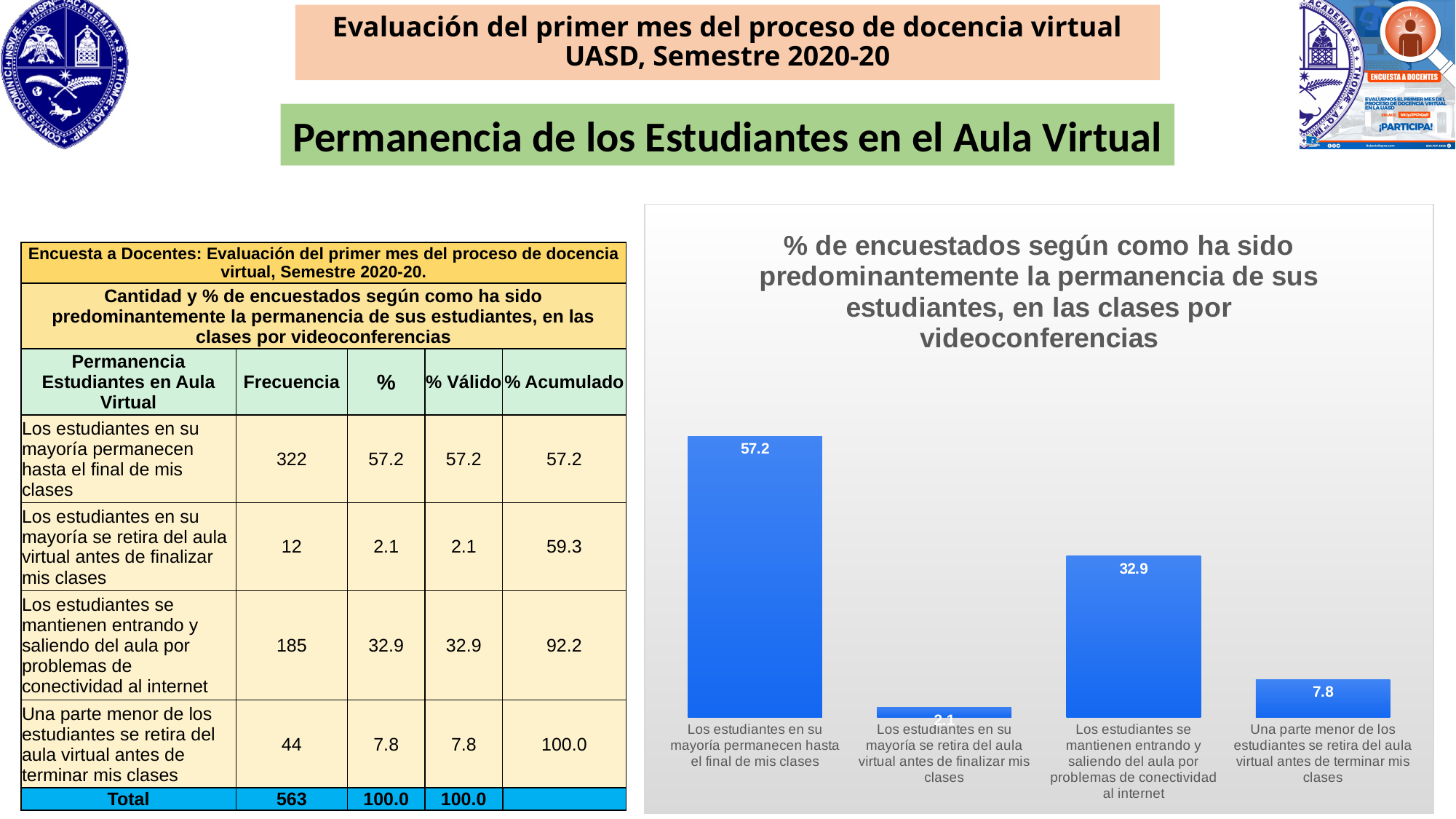
What is the difference between the values for "Los estudiantes se mantienen entrando y saliendo del aula por problemas de conectividad al internet" and "Una parte menor de los estudiantes se retira del aula virtual antes de terminar mis clases"? 25.1 What is the value for "Una parte menor de los estudiantes se retira del aula virtual antes de terminar mis clases" in the bar chart? 7.8 Which category has the lowest value in the bar chart? Los estudiantes en su mayoría se retira del aula virtual antes de finalizar mis clases What is the value for "Los estudiantes en su mayoría permanecen hasta el final de mis clases" in the bar chart? 57.2 What is the value for "Los estudiantes se mantienen entrando y saliendo del aula por problemas de conectividad al internet" in the bar chart? 32.9 What is the title of the bar chart? % de encuestados según como ha sido predominantemente la permanencia de sus estudiantes, en las clases por videoconferencias Which category has the highest value in the bar chart? Los estudiantes en su mayoría permanecen hasta el final de mis clases How many categories are plotted in the bar chart? 4 What colour are the bars in the chart? Blue What type of chart is shown on the slide? Bar chart Which is larger: the value for "Los estudiantes se mantienen entrando y saliendo del aula por problemas de conectividad al internet" or the value for "Una parte menor de los estudiantes se retira del aula virtual antes de terminar mis clases"? Los estudiantes se mantienen entrando y saliendo del aula por problemas de conectividad al internet What is the difference between the values for "Los estudiantes en su mayoría permanecen hasta el final de mis clases" and "Los estudiantes se mantienen entrando y saliendo del aula por problemas de conectividad al internet"? 24.3